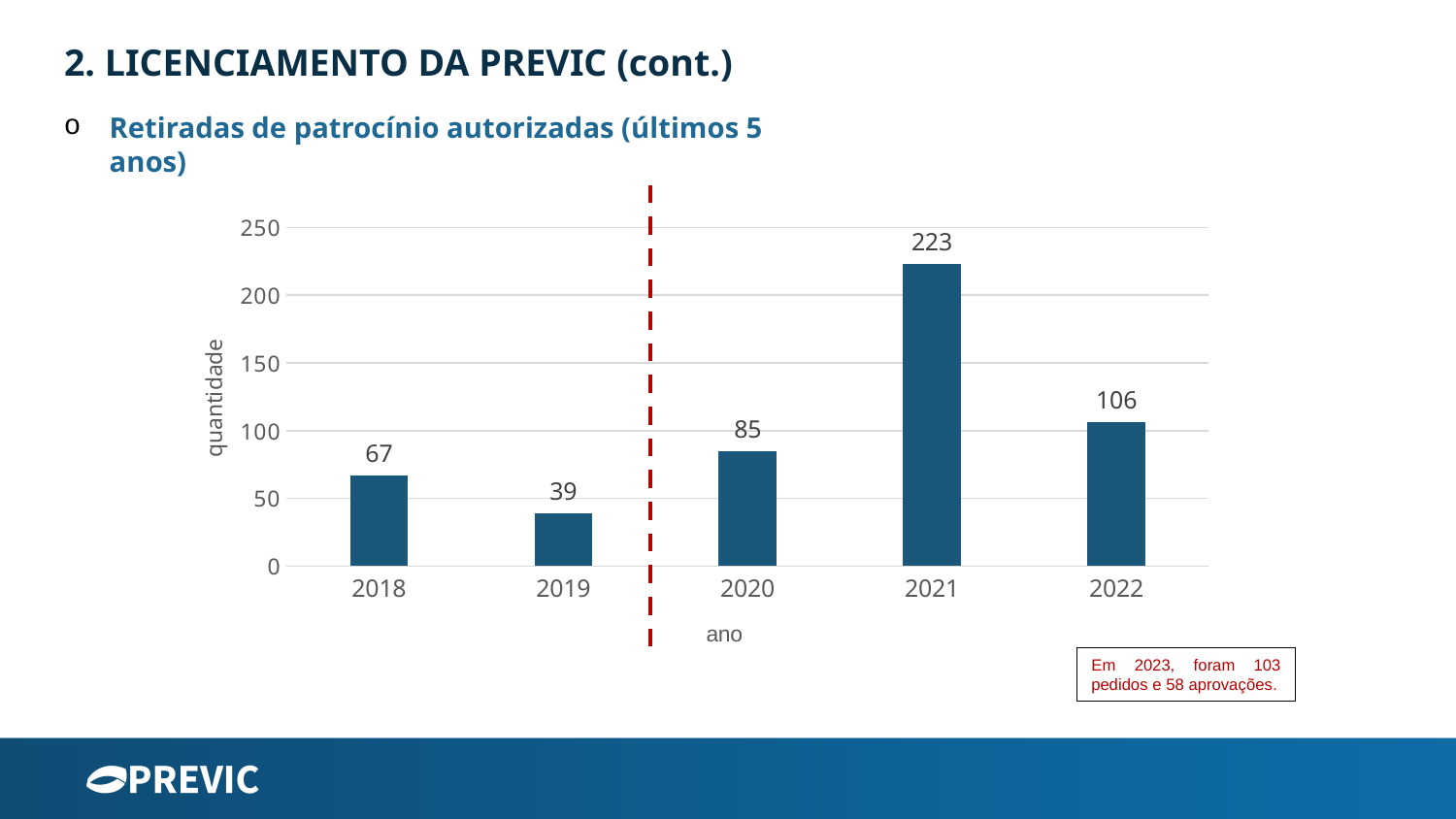
How many years are shown on the x axis? 5 Is the value for 2022 greater or less than 100? greater Which is larger, the value for 2018 or the value for 2020? 2020 What is the value for 2022? 106 What is the difference between the values for 2021 and 2022? 117 Which year has the lowest value? 2019 What kind of chart is shown? bar chart What is the label of the y axis? quantidade What is the value for 2018? 67 What is the value for 2021? 223 What is the difference between the values for 2020 and 2019? 46 Which year has the highest value? 2021